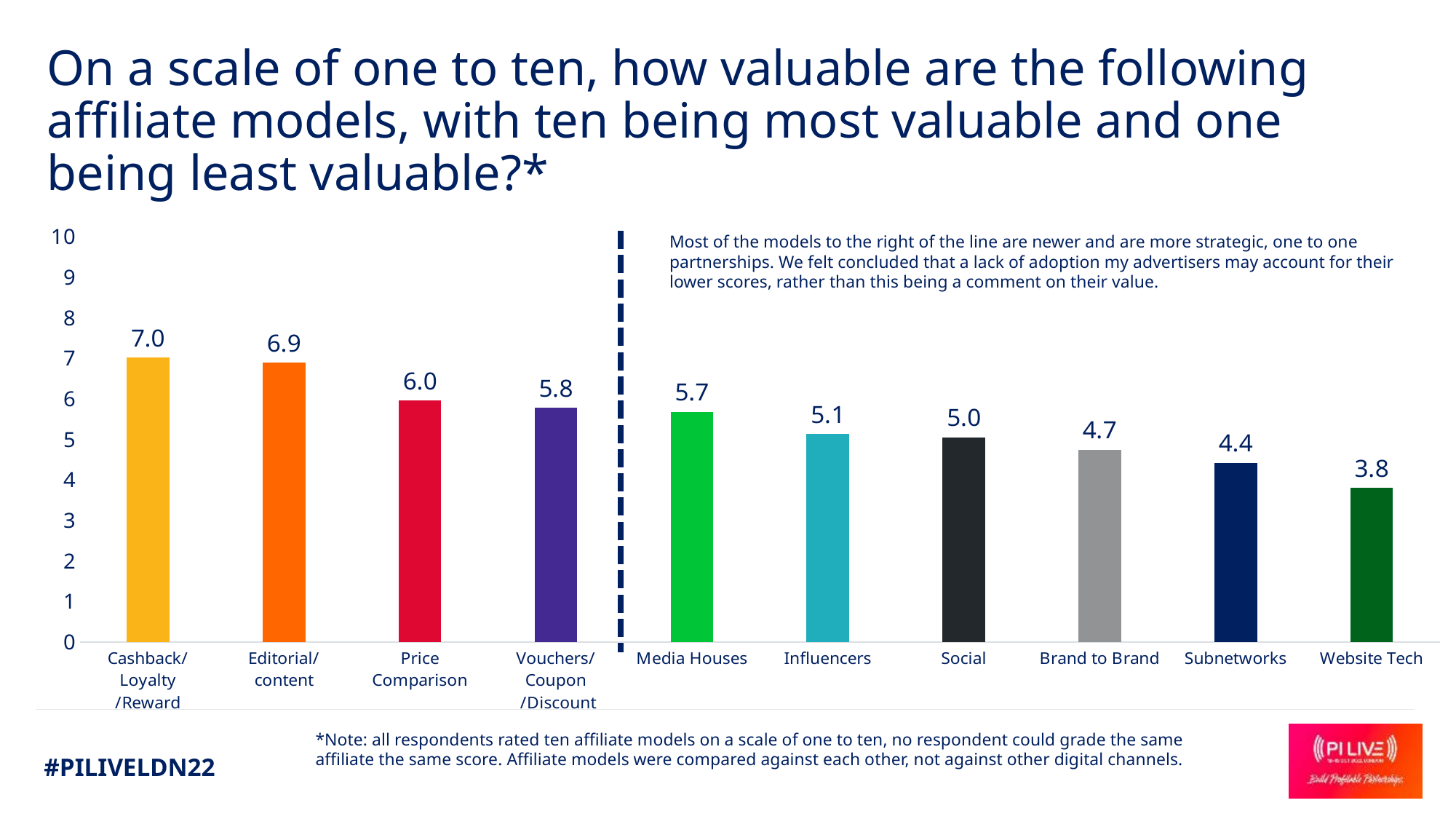
How many affiliate models are shown in the chart? 10 Which affiliate model has the lowest value? Website Tech What is the difference between the values for Cashback/Loyalty/Reward and Website Tech? 3.2 What is the difference between the values for Influencers and Subnetworks? 0.7 What is the value for Price Comparison? 6.0 What is the value for Media Houses? 5.7 Which is larger, the value for Vouchers/Coupon/Discount or the value for Social? Vouchers/Coupon/Discount What kind of chart is shown on the slide? Bar chart What is the value for Brand to Brand? 4.7 What is the maximum value shown on the vertical axis? 10 Which affiliate model has the highest value? Cashback/Loyalty/Reward Do the values rise or fall from left to right across the chart? Fall